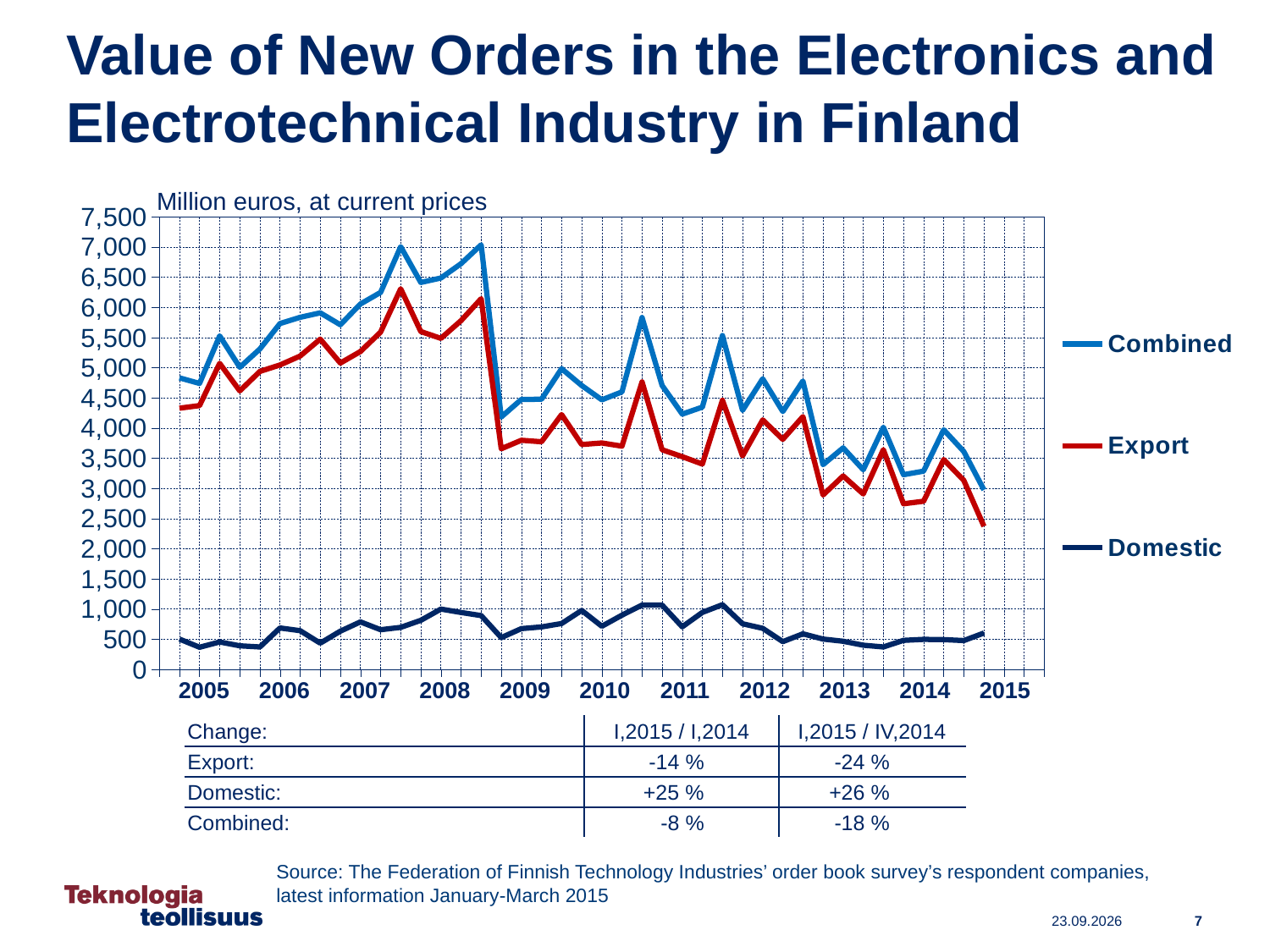
In 2010, which is larger, the Combined value or the Domestic value? Combined Does the Combined series rise or fall between 2008 and 2015? Fall What kind of chart is shown on the slide? Line chart Is the Domestic value in 2011 greater or less than 500? greater Is the peak Combined value in 2008 greater or less than 6,500? greater Which series is plotted highest on the chart throughout the period? Combined Is the Export value at the start of 2005 greater or less than 4,000? greater How many series does the legend list? 3 How many year labels are shown on the x axis? 11 What unit is stated above the y axis of the chart? Million euros, at current prices Which series is plotted lowest on the chart throughout the period? Domestic